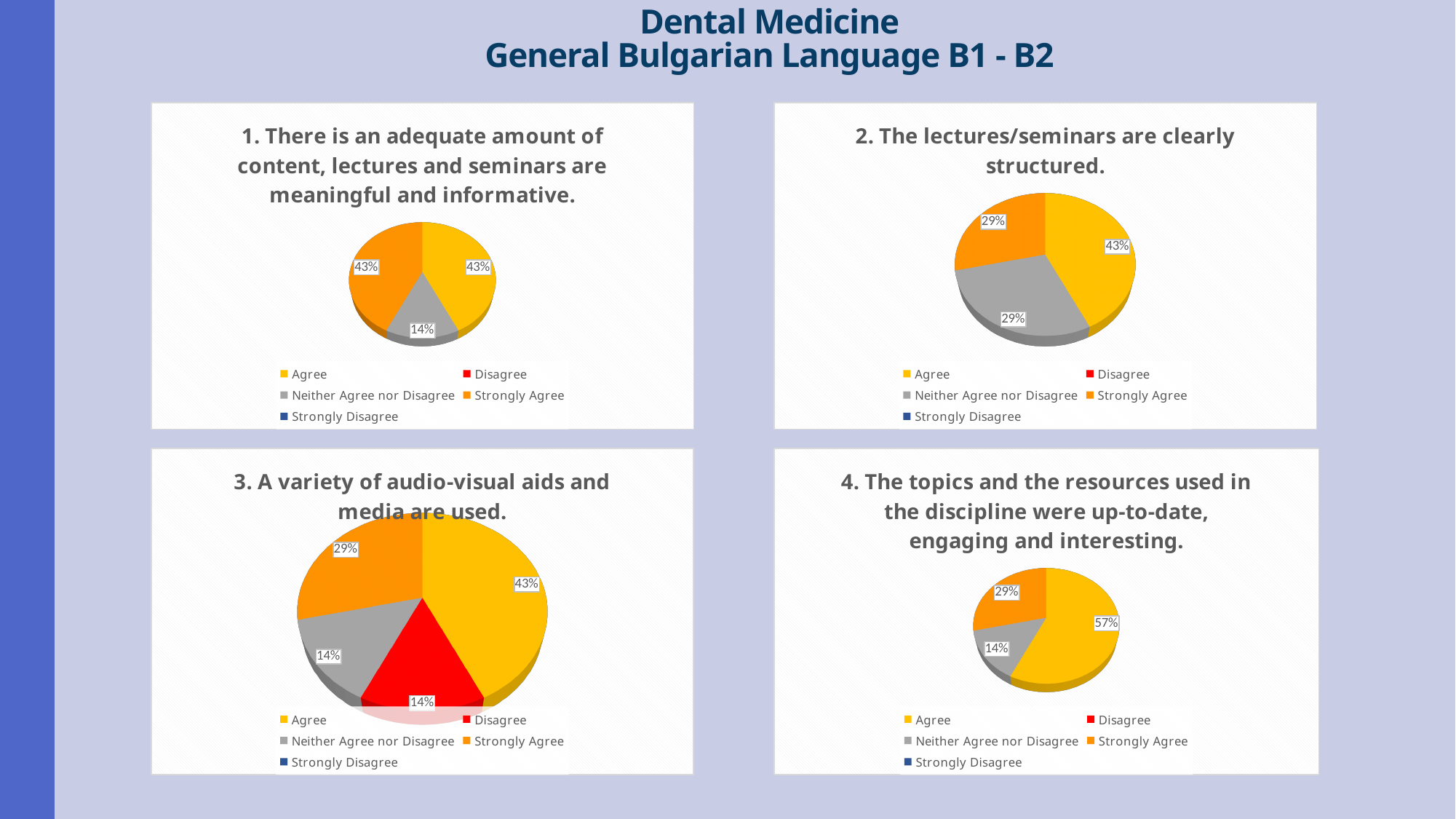
In the chart titled '3. A variety of audio-visual aids and media are used.', which is larger, 'Agree' or 'Strongly Agree'? Agree In the chart titled '4. The topics and the resources used in the discipline were up-to-date, engaging and interesting.', what percentage is shown for 'Agree'? 57% In the chart titled '1. There is an adequate amount of content, lectures and seminars are meaningful and informative.', what share of the pie is 'Neither Agree nor Disagree'? 14% In the chart titled '2. The lectures/seminars are clearly structured.', what is the difference between the 'Agree' and 'Strongly Agree' percentages? 14% In the chart titled '3. A variety of audio-visual aids and media are used.', what percentage is shown for 'Disagree'? 14% In the chart titled '3. A variety of audio-visual aids and media are used.', how many slices does the pie have? 4 In the chart titled '2. The lectures/seminars are clearly structured.', what percentage is shown for 'Neither Agree nor Disagree'? 29% What type of chart is used in the chart titled '4. The topics and the resources used in the discipline were up-to-date, engaging and interesting.'? Pie chart How many entries does the legend list in the chart titled '1. There is an adequate amount of content, lectures and seminars are meaningful and informative.'? 5 In the chart titled '1. There is an adequate amount of content, lectures and seminars are meaningful and informative.', what percentage is shown for 'Strongly Agree'? 43% In the chart titled '2. The lectures/seminars are clearly structured.', which category has the largest slice? Agree In the chart titled '4. The topics and the resources used in the discipline were up-to-date, engaging and interesting.', which category has the smallest slice? Neither Agree nor Disagree